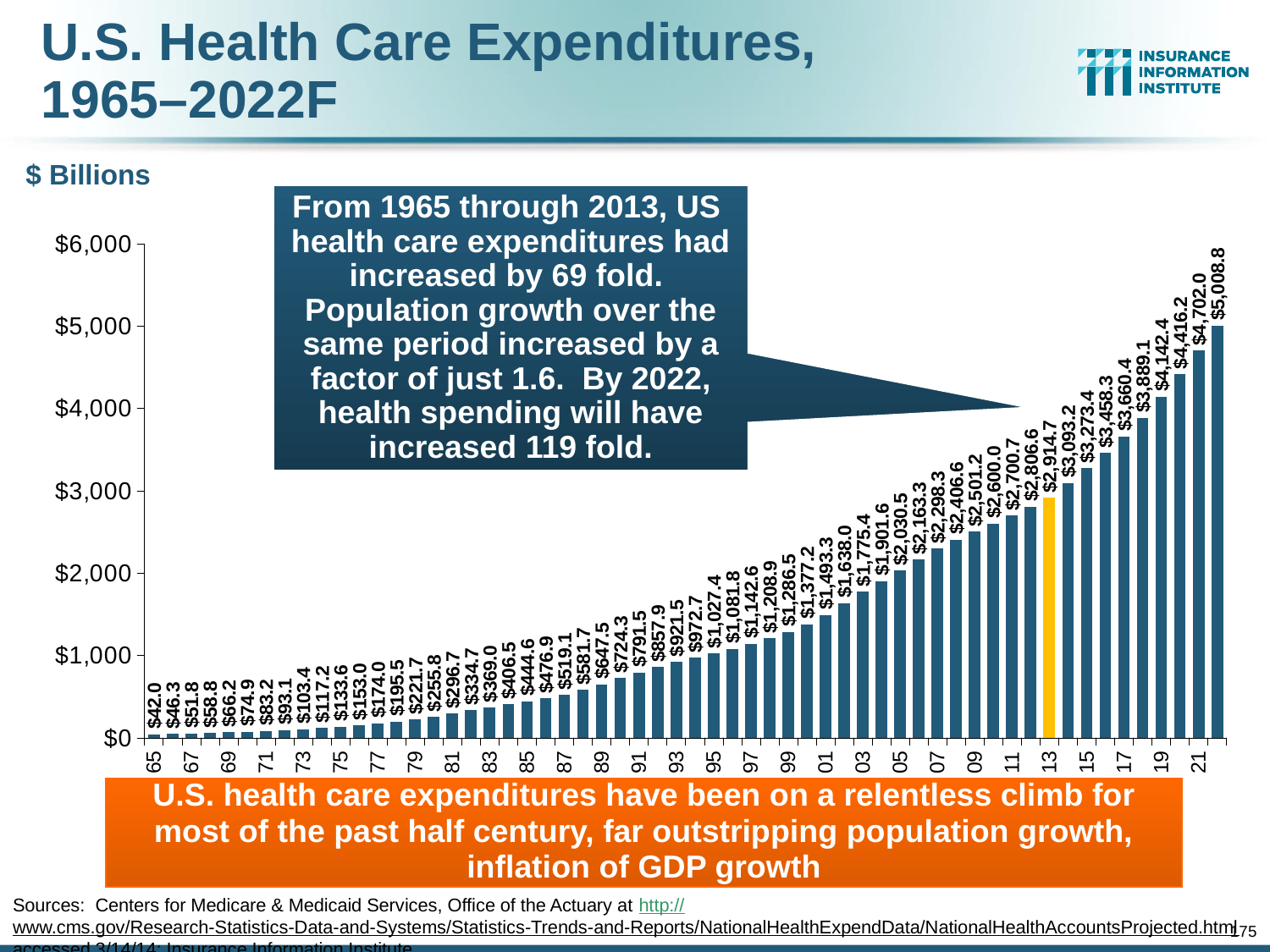
Which year has the lowest health care expenditure value in the chart? 1965 (65) Is the value for 2013 greater or less than $2,000? greater What type of chart is shown on the slide? Bar chart Which year's bar is highlighted in orange/yellow rather than blue? 2013 (13) What is the value shown for 2022 (the last bar)? $5,008.8 What is the difference between the 2022 value and the 2013 value? $2,094.1 Which year has the highest health care expenditure value in the chart? 2022 (22) What is the value shown for 1965 (the first bar)? $42.0 How many bars (years) are plotted in the chart? 58 What is the difference between the 2022 value and the 1965 value? $4,966.8 Do the values generally rise or fall from left to right along the x axis? Rise What is the value shown for the highlighted bar for 2013? $2,914.7